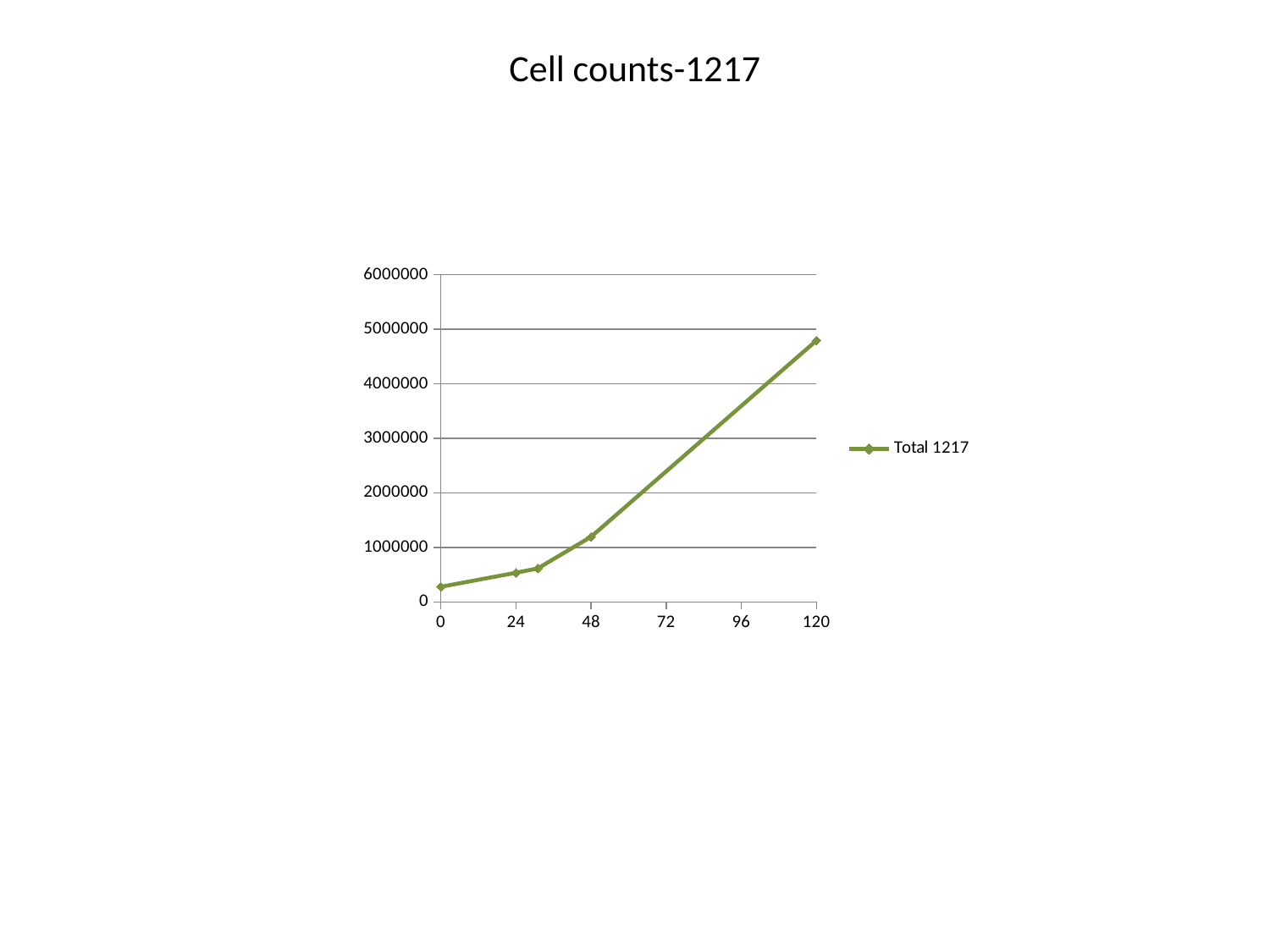
Is the value of Total 1217 at x = 48 greater or less than 1000000? greater Which is larger, the value of Total 1217 at x = 48 or at x = 24? x = 48 What is the title of the chart? Cell counts-1217 What kind of chart is shown on the slide? line chart How many series does the legend list? 1 At which x value is Total 1217 highest? 120 What is the name of the series shown in the legend? Total 1217 At which x value is Total 1217 lowest? 0 Is the value of Total 1217 at x = 120 greater or less than 5000000? less Is the value of Total 1217 at x = 120 greater or less than 4000000? greater Do the values of Total 1217 rise or fall as the x axis increases from 0 to 120? rise